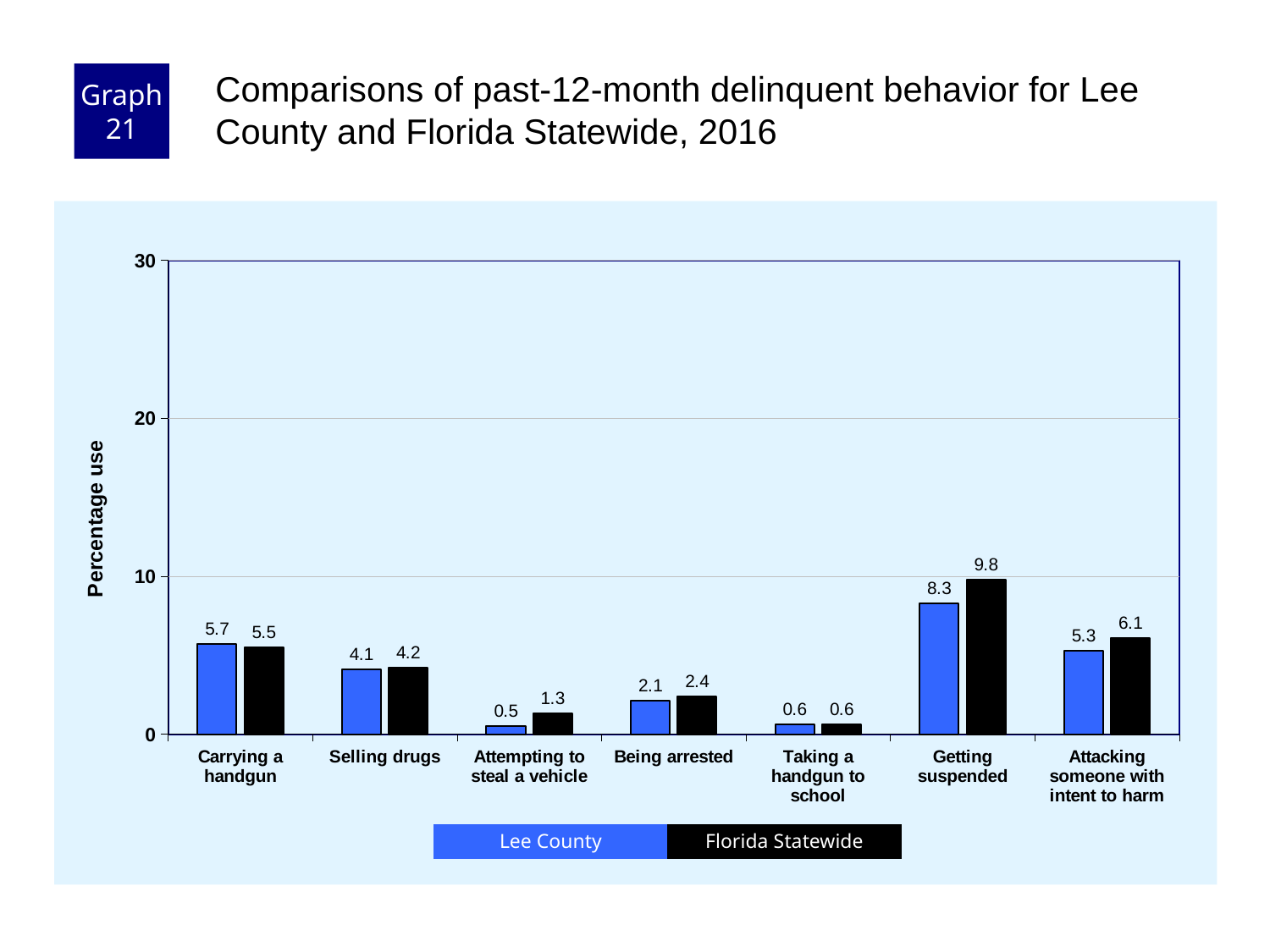
What is the Lee County value for Getting suspended? 8.3 Which category has the highest Florida Statewide value? Getting suspended For Carrying a handgun, which is larger: the Lee County value or the Florida Statewide value? Lee County What is the difference between the Florida Statewide and Lee County values for Getting suspended? 1.5 Which category has the lowest Lee County value? Attempting to steal a vehicle How many series does the legend list? 2 What kind of chart is shown on the slide? bar chart How many categories are shown on the x axis? 7 What is the difference between the Florida Statewide and Lee County values for Attempting to steal a vehicle? 0.8 What is the Lee County value for Being arrested? 2.1 Is the Florida Statewide value for Getting suspended greater or less than 10? less What is the Florida Statewide value for Attempting to steal a vehicle? 1.3